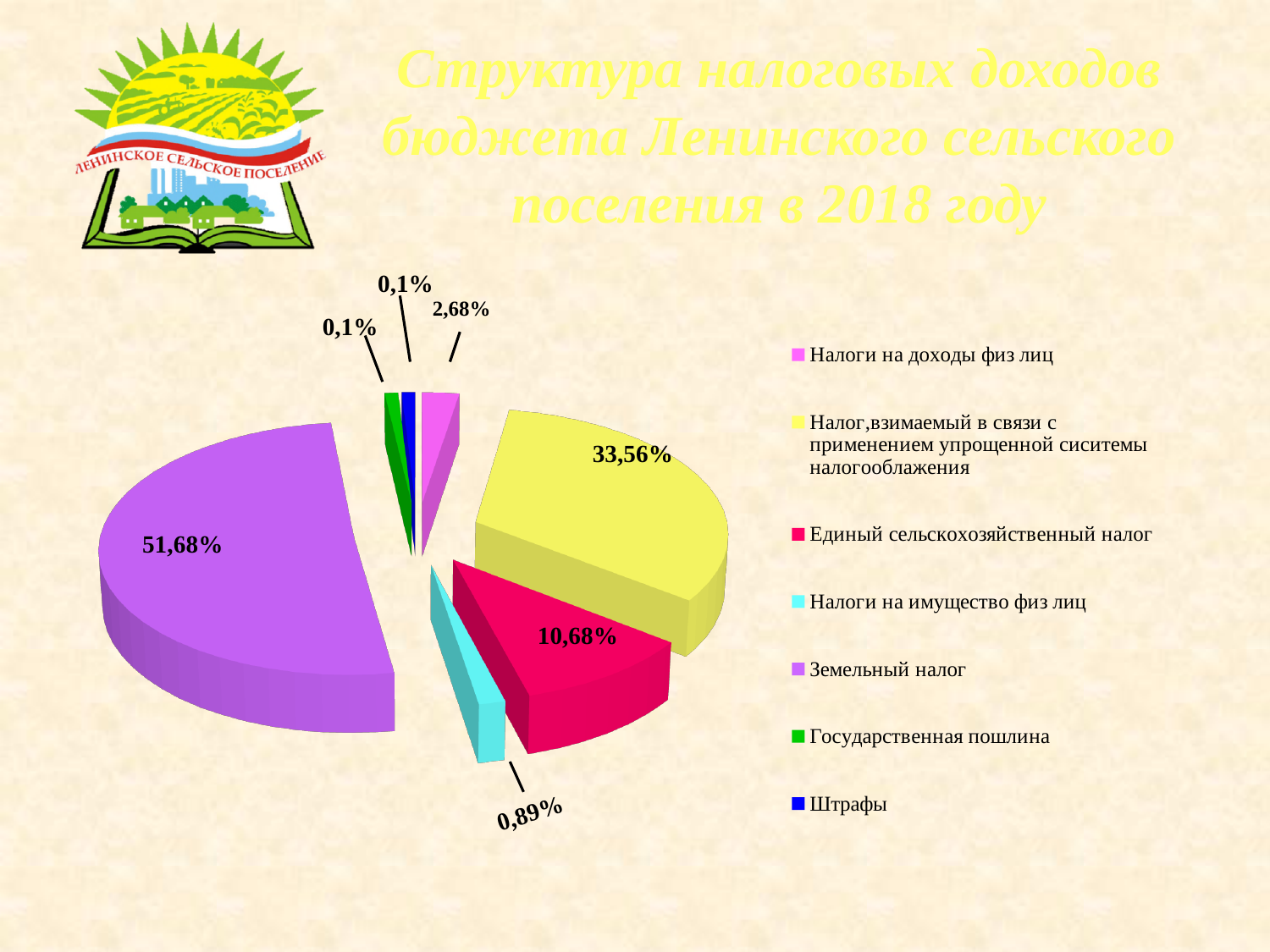
What kind of chart is shown on the slide? Pie chart What is the difference between the shares of Земельный налог and Налог, взимаемый в связи с применением упрощенной системы налогообложения? 18,12% What percentage is shown for Налоги на имущество физ лиц? 0,89% Which category has the larger share: Единый сельскохозяйственный налог or Налоги на доходы физ лиц? Единый сельскохозяйственный налог What year does the chart title refer to? 2018 What percentage is shown for Единый сельскохозяйственный налог? 10,68% What percentage is shown for Налоги на доходы физ лиц? 2,68% Which category has the largest share of the pie? Земельный налог What colour is the slice for Штрафы? Blue What is the value shown for Налог, взимаемый в связи с применением упрощенной системы налогообложения? 33,56% How many categories does the legend list? 7 What share of tax revenues does Земельный налог account for? 51,68%